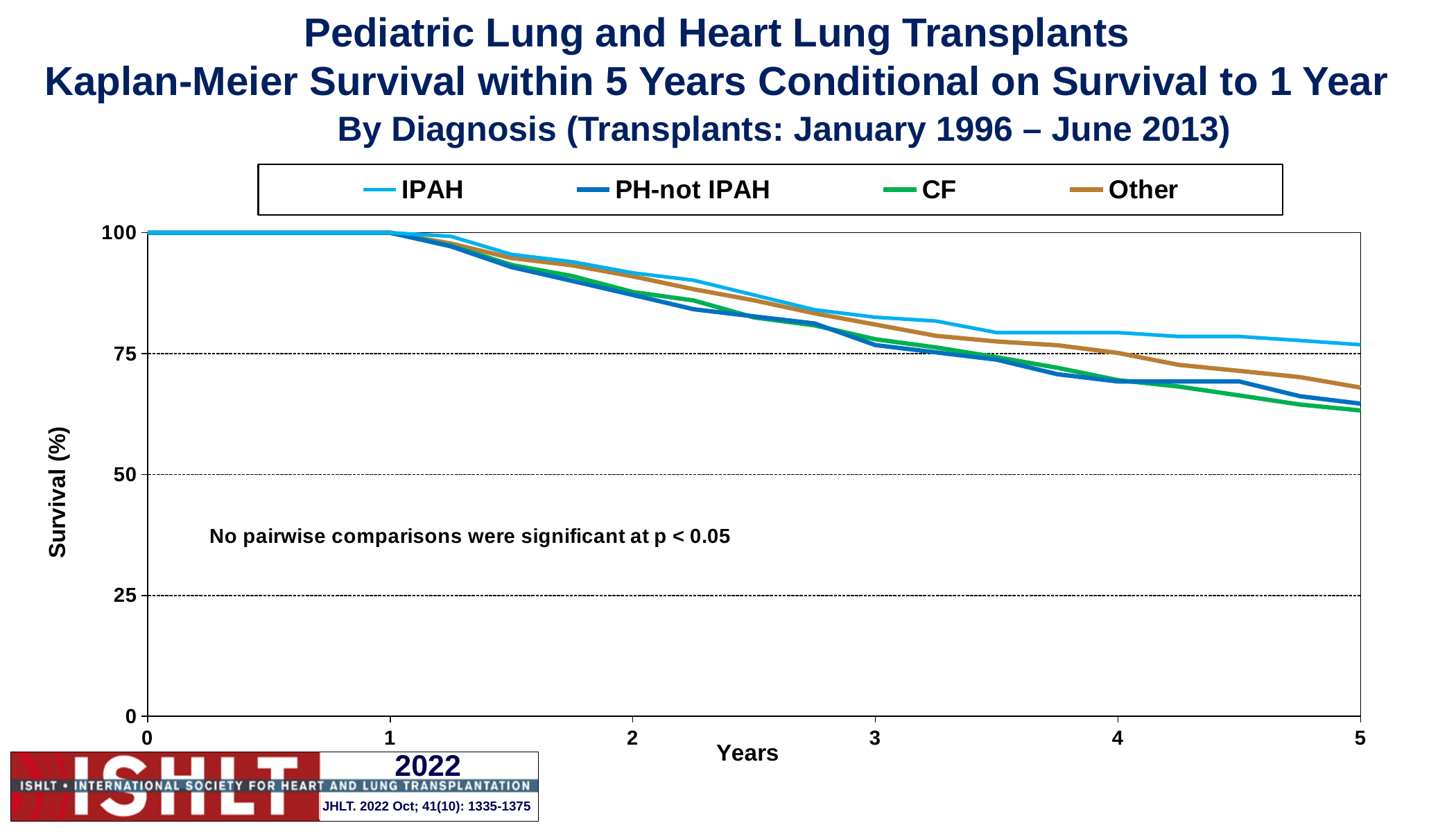
Is the survival value for IPAH at year 3 greater or less than 75? greater At year 5, which has the larger survival value, IPAH or CF? IPAH What kind of chart is shown on the slide? line chart Is the survival value for Other at year 5 greater or less than 75? less Do the survival curves rise or fall as years increase from 1 to 5? fall How many series does the legend list? 4 What is the label of the y axis? Survival (%) Which diagnosis group has the highest survival at year 5? IPAH Is the survival value for PH-not IPAH at year 5 greater or less than 50? greater What note is printed inside the plot area about pairwise comparisons? No pairwise comparisons were significant at p < 0.05 What is the survival value for all four diagnosis groups at year 1? 100